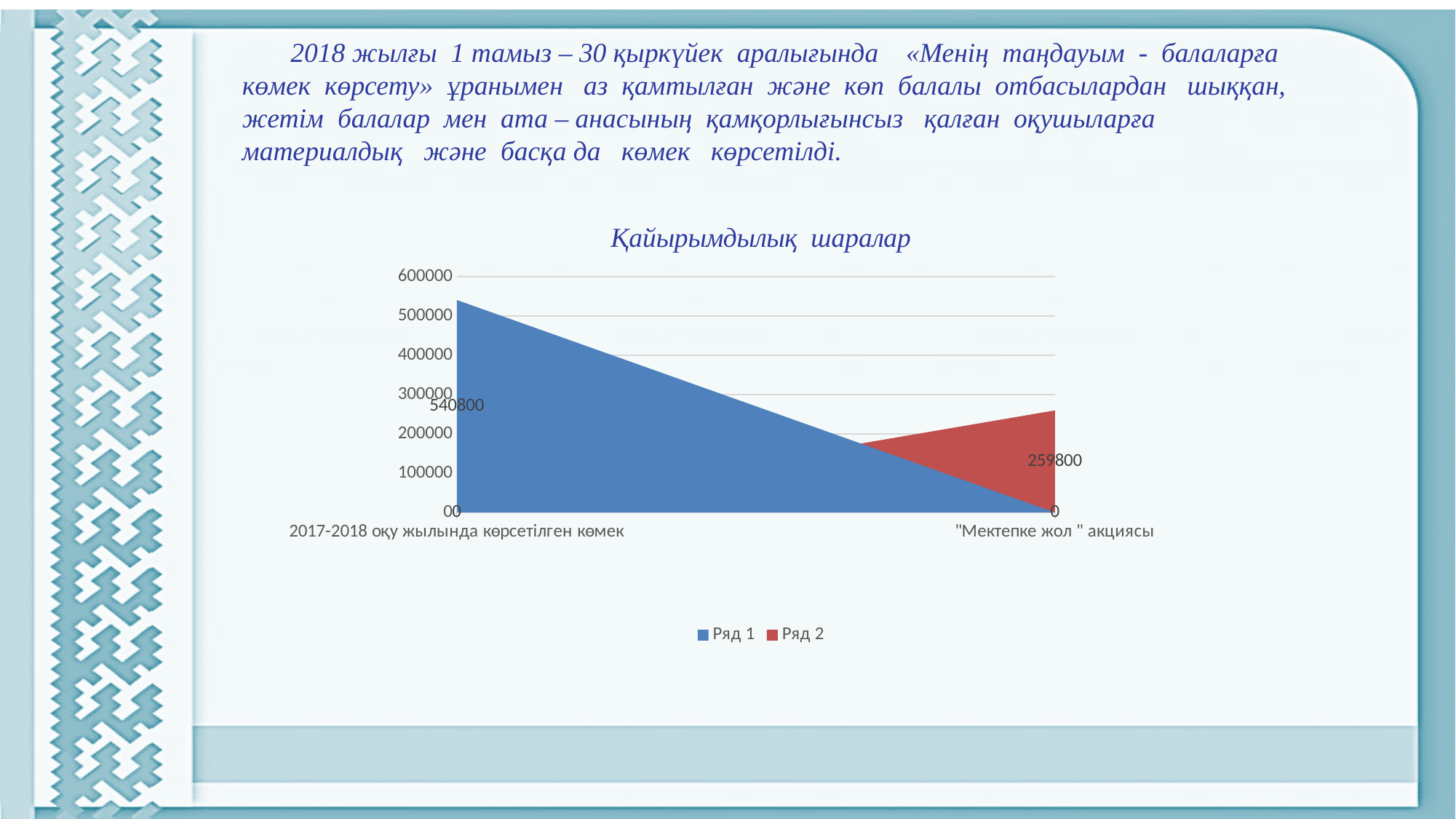
What is the value of Ряд 1 for "2017-2018 оқу жылында көрсетілген көмек"? 540800 What is the difference between the Ряд 1 value for "2017-2018 оқу жылында көрсетілген көмек" and the Ряд 2 value for "Мектепке жол" акциясы? 281000 How many categories are shown on the x axis? 2 What is the value of Ряд 1 for "Мектепке жол" акциясы? 0 Does the value of Ряд 1 rise or fall from "2017-2018 оқу жылында көрсетілген көмек" to "Мектепке жол" акциясы? fall How many series does the legend list? 2 Which is larger: the Ряд 1 value for "2017-2018 оқу жылында көрсетілген көмек" or the Ряд 2 value for "Мектепке жол" акциясы? Ряд 1 value for "2017-2018 оқу жылында көрсетілген көмек" What is the title of the chart? Қайырымдылық шаралар What type of chart is shown on the slide? area chart What colour represents Ряд 2 in the chart? red What is the value of Ряд 2 for "2017-2018 оқу жылында көрсетілген көмек"? 0 What is the value of Ряд 2 for "Мектепке жол" акциясы? 259800